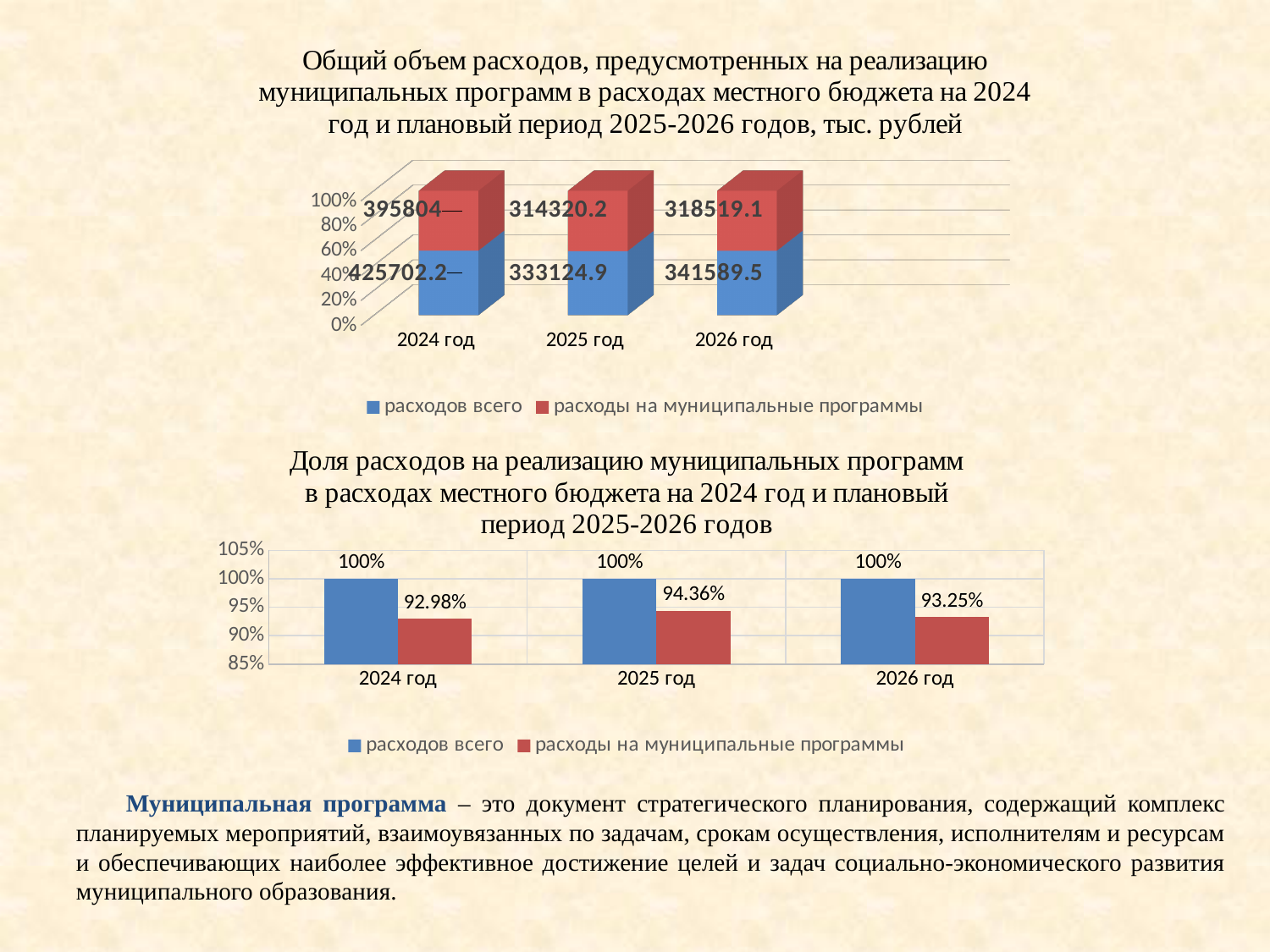
In the bottom chart, what is the value for 'расходы на муниципальные программы' in 2025 год? 94.36% In the bottom chart, how many year categories are shown on the x axis? 3 In the top chart, what is the difference between 'расходов всего' and 'расходы на муниципальные программы' in 2024 год? 29898.2 In the top chart, which year has the highest value for 'расходов всего'? 2024 год In the top chart, which year has the lowest value for 'расходы на муниципальные программы'? 2025 год In the top chart, what is the value for 'расходов всего' in 2024 год? 425702.2 In the top chart, what is the value for 'расходы на муниципальные программы' in 2025 год? 314320.2 What kind of chart is the bottom chart? bar chart In the bottom chart, what is the value for 'расходы на муниципальные программы' in 2024 год? 92.98% In the top chart, how many series does the legend list? 2 In the top chart, what is the value for 'расходы на муниципальные программы' in 2026 год? 318519.1 In the bottom chart, which year has the lowest share for 'расходы на муниципальные программы'? 2024 год